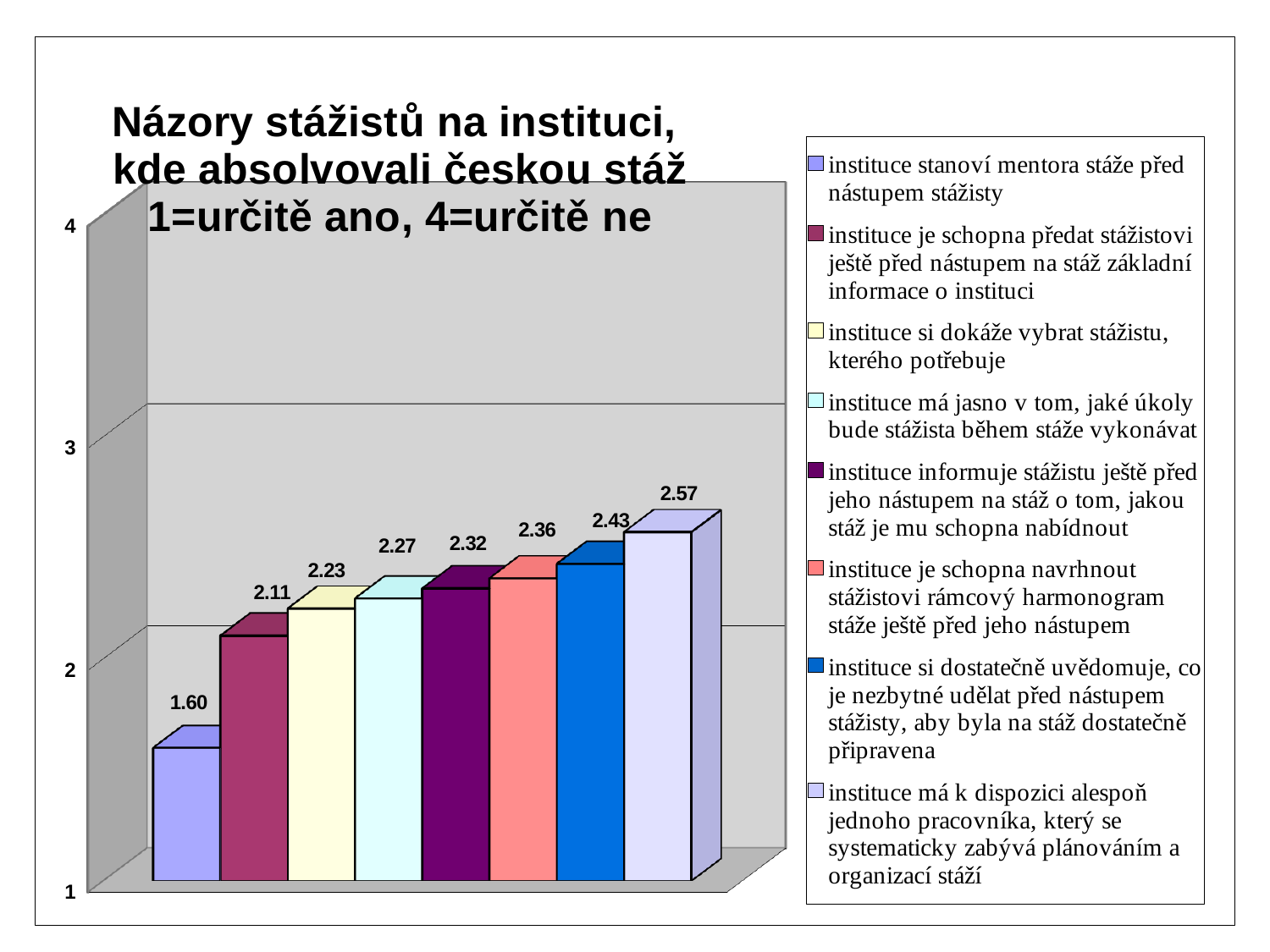
What is the value for "instituce je schopna navrhnout stážistovi rámcový harmonogram stáže ještě před jeho nástupem"? 2.36 How many series does the legend list? 8 What is the value for "instituce si dokáže vybrat stážistu, kterého potřebuje"? 2.23 Which legend item has the lowest value? instituce stanoví mentora stáže před nástupem stážisty What is the value for "instituce stanoví mentora stáže před nástupem stážisty"? 1.60 What is the value for "instituce má k dispozici alespoň jednoho pracovníka, který se systematicky zabývá plánováním a organizací stáží"? 2.57 How many bars are plotted in the chart? 8 What is the difference between the highest value (2.57) and the lowest value (1.60)? 0.97 Which legend item has the highest value? instituce má k dispozici alespoň jednoho pracovníka, který se systematicky zabývá plánováním a organizací stáží Is the value for "instituce si dostatečně uvědomuje, co je nezbytné udělat před nástupem stážisty, aby byla na stáž dostatečně připravena" greater or less than 3? less What kind of chart is shown on the slide? bar chart Which is larger: the value for "instituce je schopna předat stážistovi ještě před nástupem na stáž základní informace o instituci" or the value for "instituce informuje stážistu ještě před jeho nástupem na stáž o tom, jakou stáž je mu schopna nabídnout"? instituce informuje stážistu ještě před jeho nástupem na stáž o tom, jakou stáž je mu schopna nabídnout